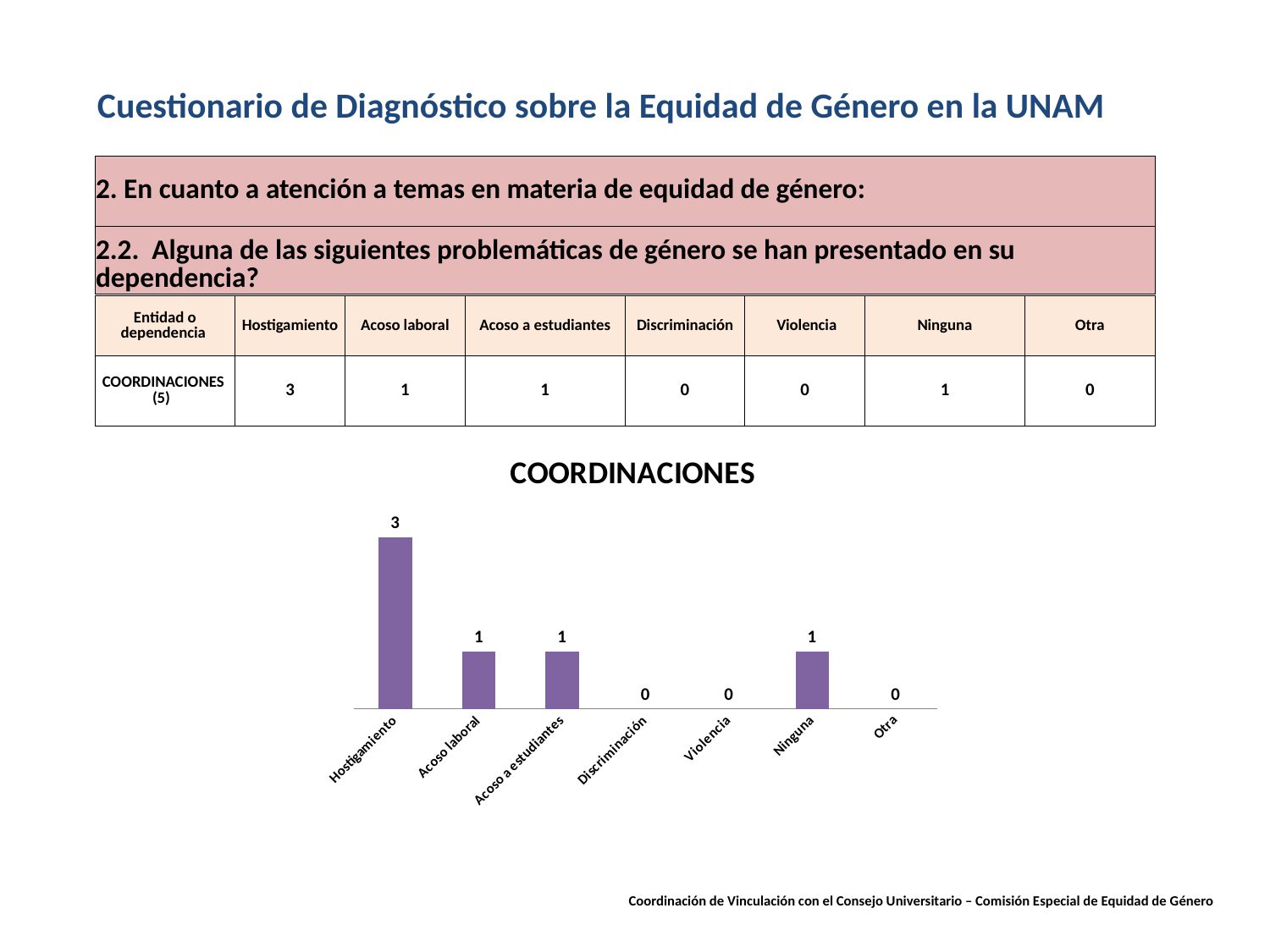
What colour are the bars in the COORDINACIONES chart? Purple What is the title of the chart on the slide? COORDINACIONES What is the value for Ninguna in the COORDINACIONES chart? 1 How many categories in the COORDINACIONES chart have a value of 0? 3 What is the value for Hostigamiento in the COORDINACIONES chart? 3 Which is larger in the COORDINACIONES chart, the value for Hostigamiento or the value for Ninguna? Hostigamiento What kind of chart is the COORDINACIONES chart? Bar chart How many categories are shown on the x axis of the COORDINACIONES chart? 7 Which category has the highest value in the COORDINACIONES chart? Hostigamiento What is the value for Acoso laboral in the COORDINACIONES chart? 1 What is the difference between the values for Hostigamiento and Acoso a estudiantes in the COORDINACIONES chart? 2 What is the value for Discriminación in the COORDINACIONES chart? 0